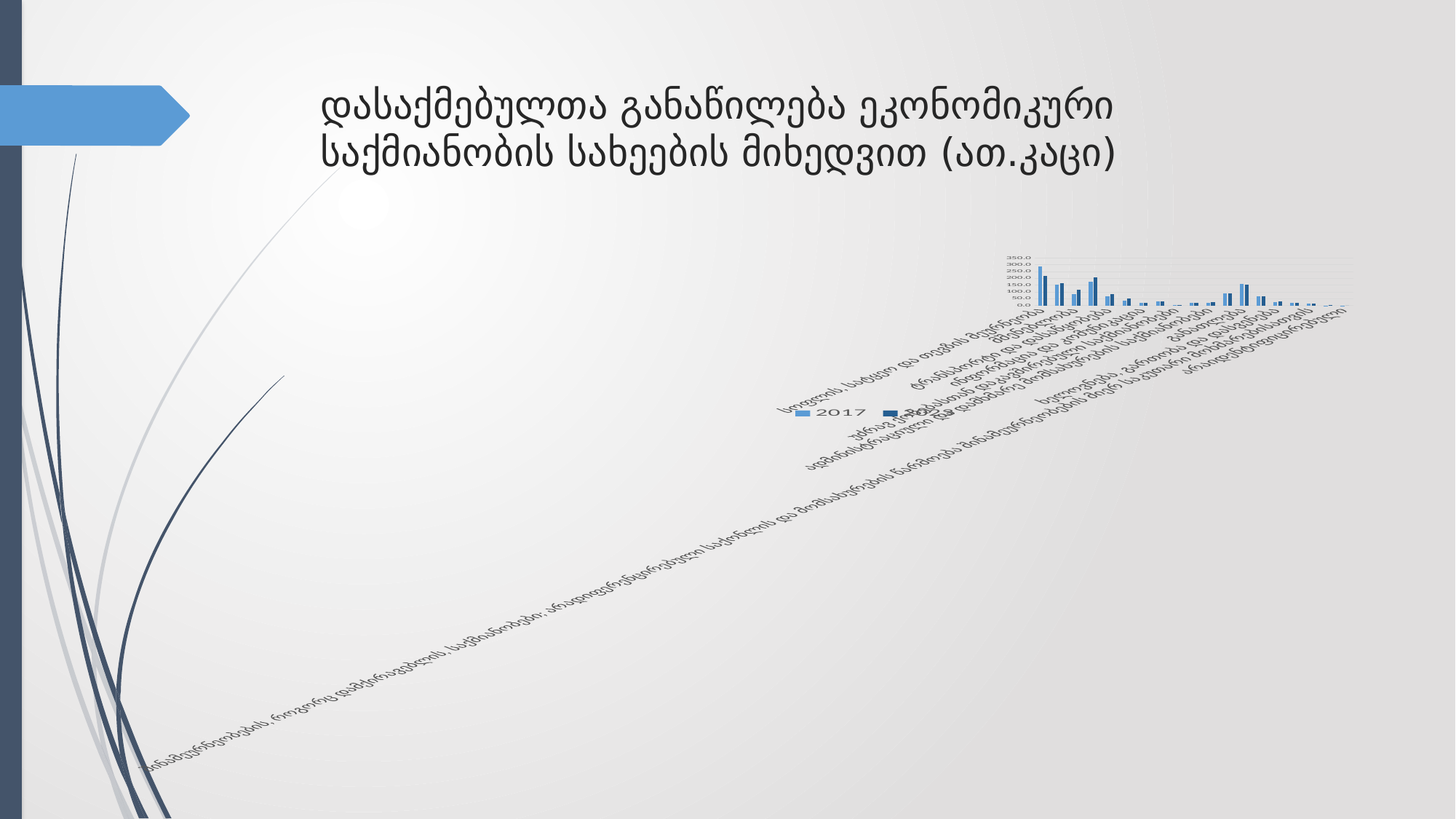
What is the highest tick value shown on the chart's vertical axis? 350.0 How many series does the chart's legend list? 2 What is the first series named in the chart's legend? 2017 What kind of chart is shown on the slide? bar chart Is the 2017 value for the leftmost category (სოფლის, სატყეო და თევზის მეურნეობა) greater or less than 250? greater Which category has the tallest bar in the chart? სოფლის, სატყეო და თევზის მეურნეობა